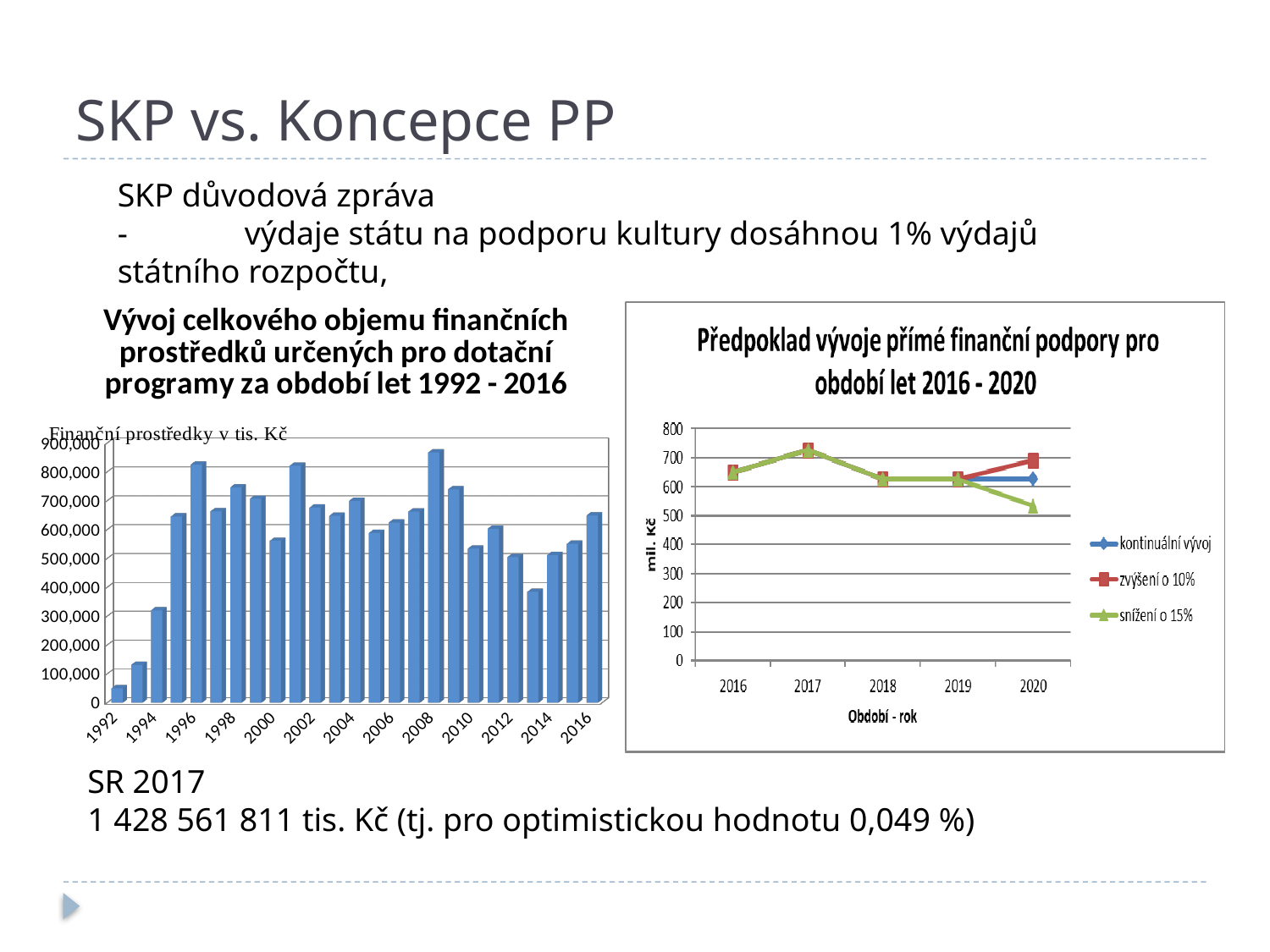
In the left bar chart, which year has the highest value? 2008 What kind of chart is the right chart titled 'Předpoklad vývoje přímé finanční podpory pro období let 2016 - 2020'? line chart What kind of chart is the left chart titled 'Vývoj celkového objemu finančních prostředků určených pro dotační programy za období let 1992 - 2016'? bar chart In the left bar chart, is the value for 1992 greater or less than 100,000? less In the left bar chart, how many years (bars) are plotted? 25 In the left bar chart, is the value for 2016 greater or less than 600,000? greater In the right line chart, how many series does the legend list? 3 In the left bar chart, which year has the lowest value? 1992 In the right line chart, how many years are plotted on the x axis? 5 In the right line chart, is the 2020 value for 'snížení o 15%' greater or less than 600? less In the right line chart, which series has the larger value in 2020: 'zvýšení o 10%' or 'snížení o 15%'? zvýšení o 10%